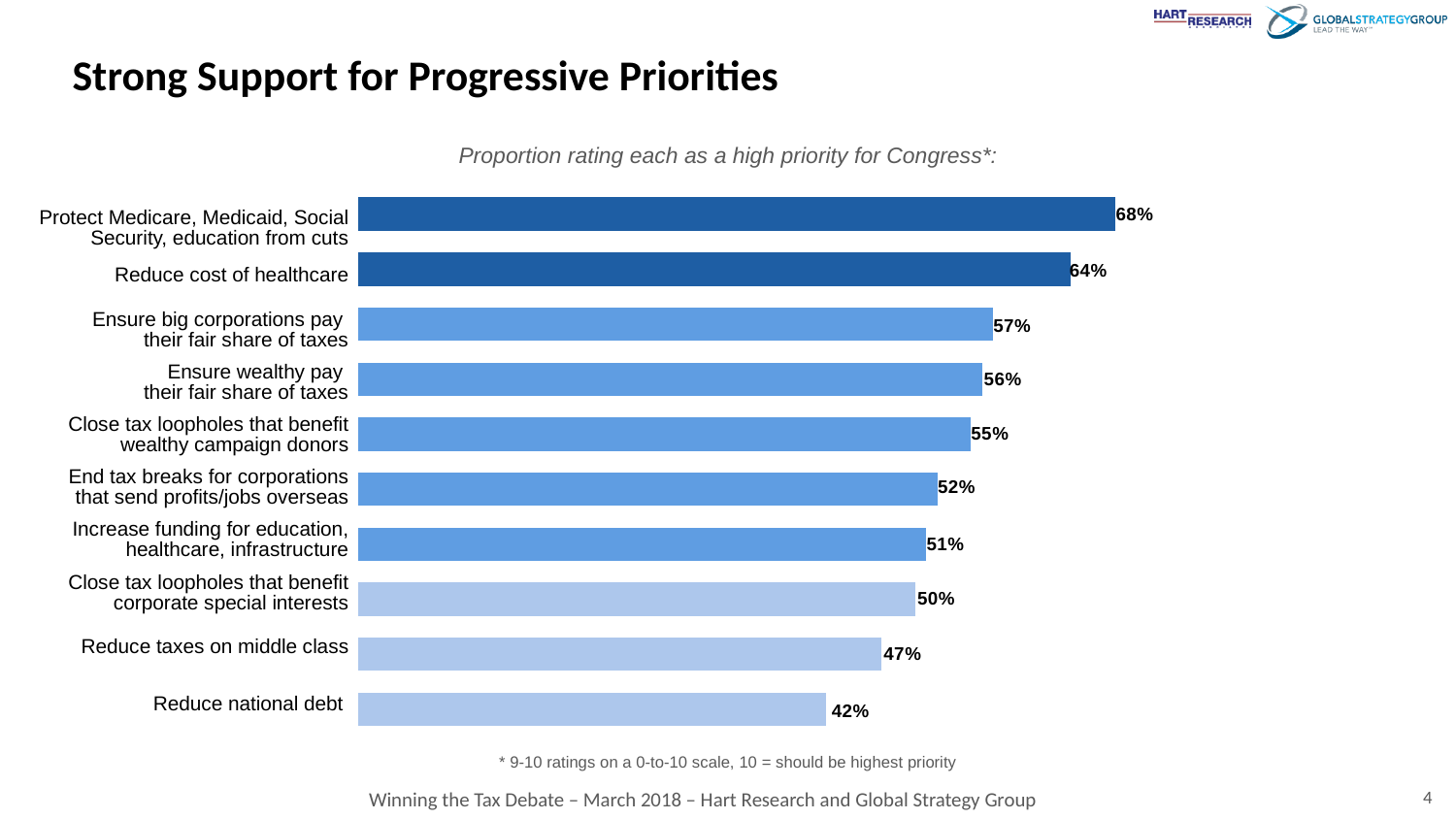
What is the subtitle above the chart describing what is plotted? Proportion rating each as a high priority for Congress*: Which item has the highest proportion rating it a high priority? Protect Medicare, Medicaid, Social Security, education from cuts What is the difference between "Ensure big corporations pay their fair share of taxes" and "Reduce taxes on middle class"? 10 percentage points Which item has the lowest proportion rating it a high priority? Reduce national debt What proportion rate "Reduce cost of healthcare" as a high priority for Congress? 64% What is the value shown for "End tax breaks for corporations that send profits/jobs overseas"? 52% What is the value shown for "Reduce national debt"? 42% Which has a higher value: "Close tax loopholes that benefit wealthy campaign donors" or "Increase funding for education, healthcare, infrastructure"? Close tax loopholes that benefit wealthy campaign donors What kind of chart is shown on the slide? Bar chart What is the difference between the values for "Protect Medicare, Medicaid, Social Security, education from cuts" and "Reduce national debt"? 26 percentage points What proportion rate "Ensure wealthy pay their fair share of taxes" as a high priority? 56% How many items are shown in the chart? 10